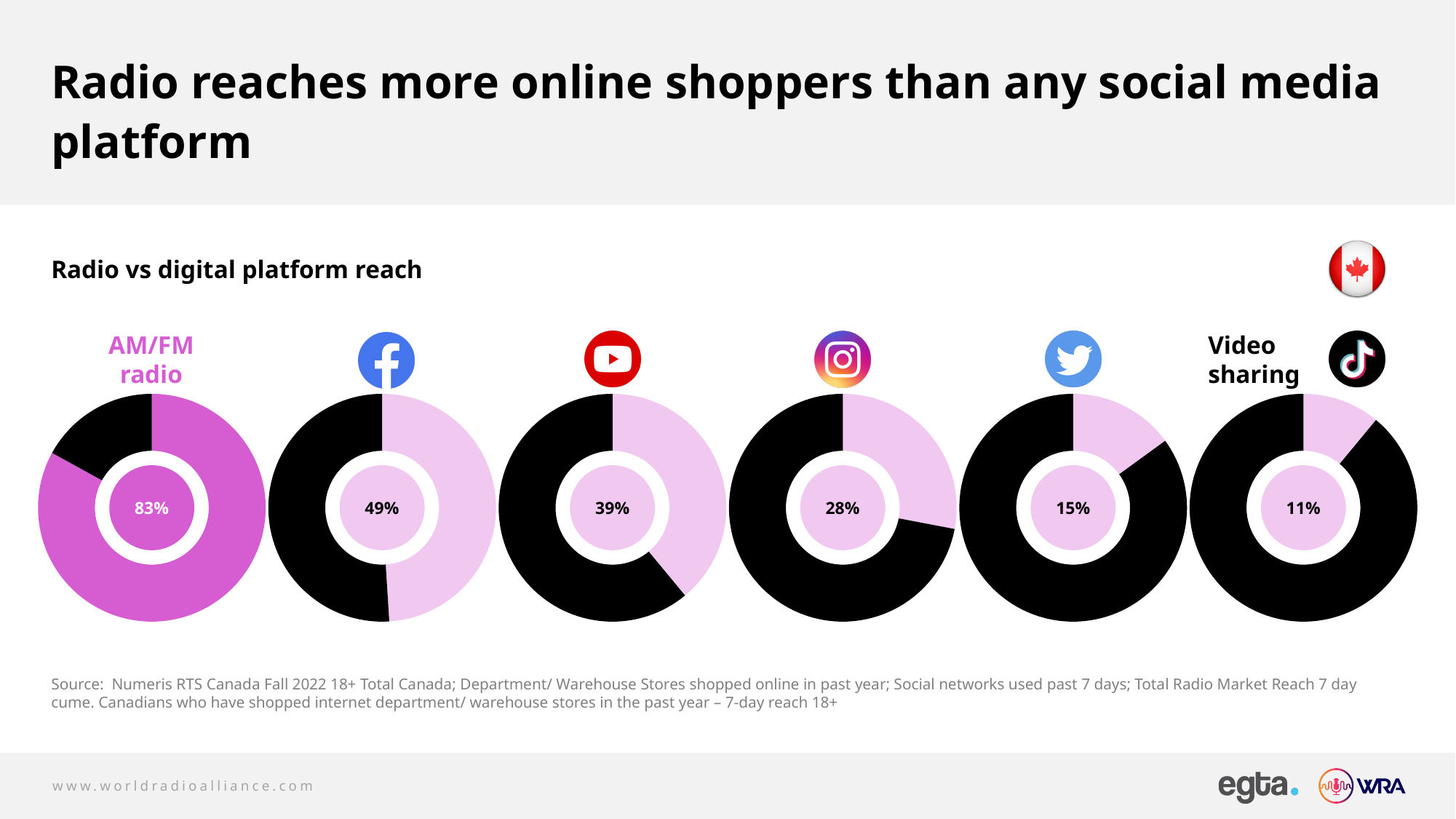
What is the value shown in the fifth donut chart from the left (Twitter icon)? 15% Which platform has the lowest reach among the donut charts? Video sharing Which platform has the highest reach among the donut charts? AM/FM radio What is the value shown in the Video sharing donut chart? 11% What is the value shown in the AM/FM radio donut chart? 83% Which is larger, the value in the second donut chart from the left (Facebook icon) or the third donut chart from the left (YouTube icon)? Facebook (49%) What is the difference between the AM/FM radio value and the Video sharing value? 72% What is the value shown in the second donut chart from the left (Facebook icon)? 49% What is the value shown in the fourth donut chart from the left (Instagram icon)? 28% How many donut charts are shown on the slide? 6 What is the title of the chart section on the slide? Radio vs digital platform reach What is the value shown in the third donut chart from the left (YouTube icon)? 39%